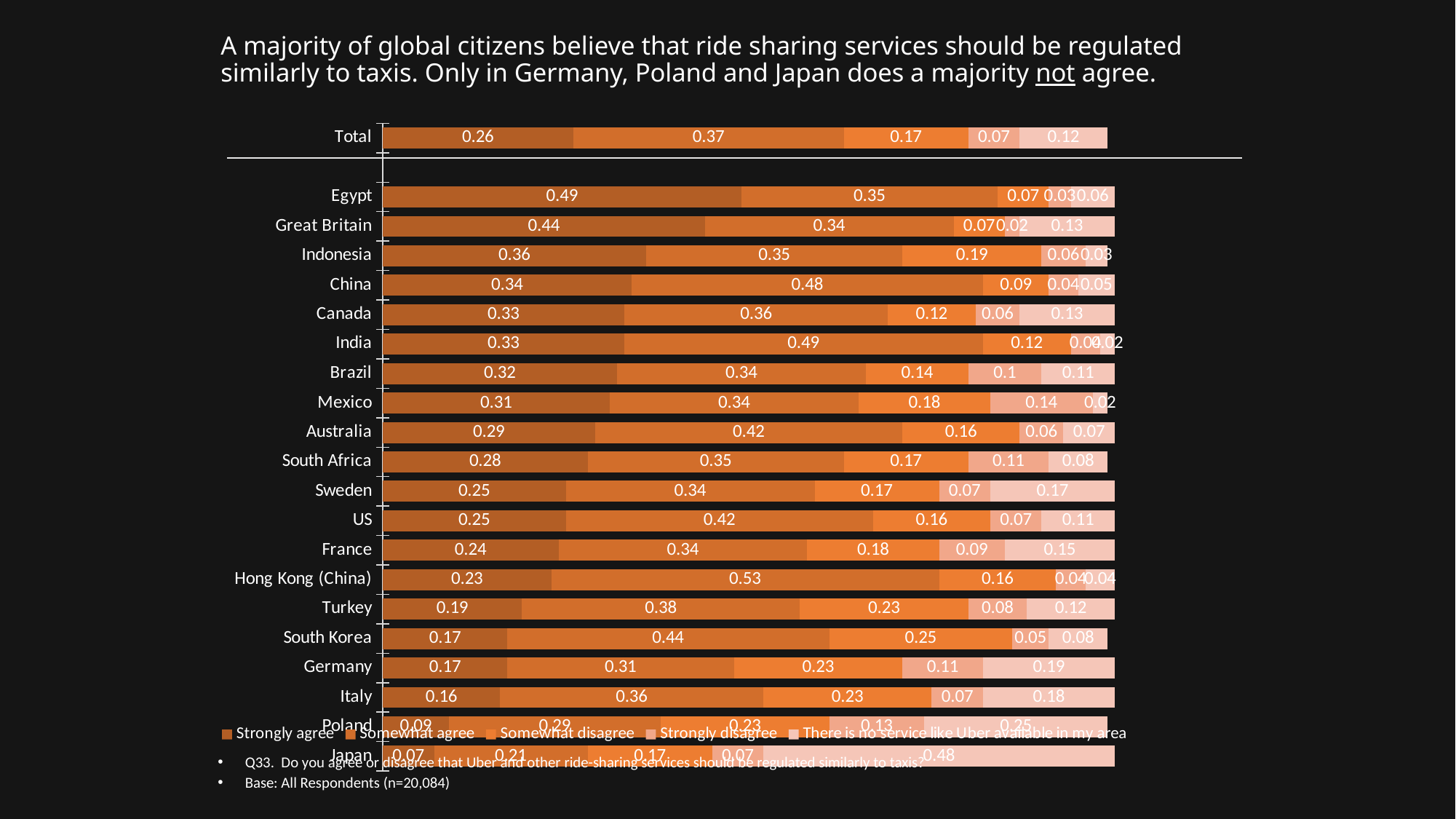
What is the difference between the Strongly agree values for Egypt and Great Britain? 0.05 Which country has the highest Strongly agree value? Egypt How many countries are listed in the chart, excluding the Total bar? 20 What is the combined value of Strongly agree and Somewhat agree for Germany? 0.48 Which country has the lowest Strongly agree value? Japan What is the value for Strongly agree for Egypt? 0.49 Which has a larger Strongly agree value, Canada or Turkey? Canada What is the value for 'There is no service like Uber available in my area' for Japan? 0.48 How many series does the legend list? 5 What is the Somewhat agree value for Hong Kong (China)? 0.53 What is the Somewhat agree value for the Total bar? 0.37 What kind of chart is shown on the slide? Stacked bar chart